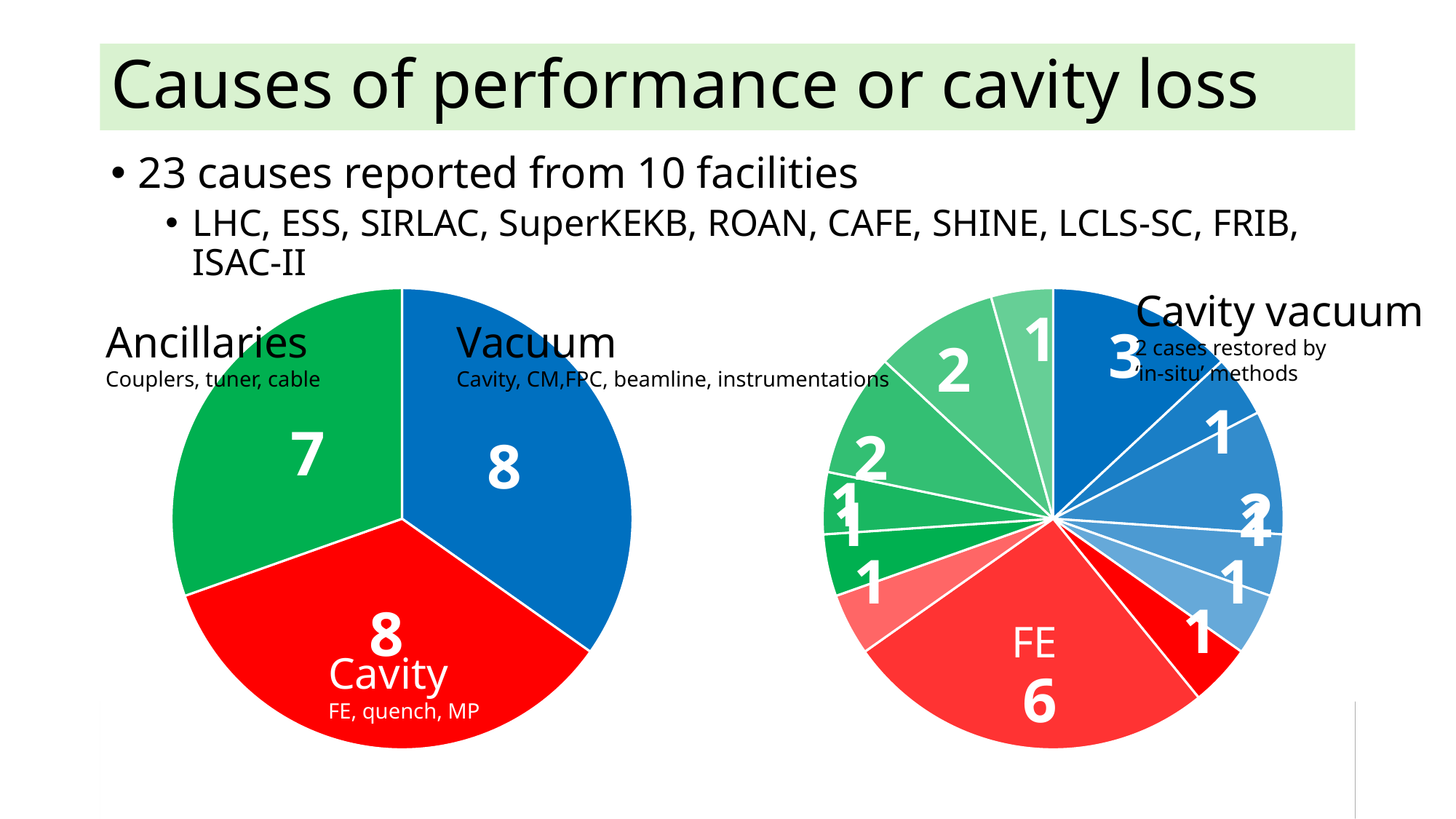
In the left pie chart, which category has the smallest value? Ancillaries In the left pie chart, which is larger, Cavity or Ancillaries? Cavity In the left pie chart, what is the value for Cavity? 8 In the right pie chart, what is the value for Cavity vacuum? 3 What is the total of all slices in the left pie chart? 23 In the left pie chart, what is the difference between the Vacuum value and the Ancillaries value? 1 In the left pie chart, what is the value for Ancillaries? 7 In the right pie chart, which labelled slice has the largest value? FE In the right pie chart, what is the value for FE? 6 What kind of chart is the left chart on the slide? pie chart How many slices does the left pie chart have? 3 In the left pie chart, what is the value for Vacuum? 8